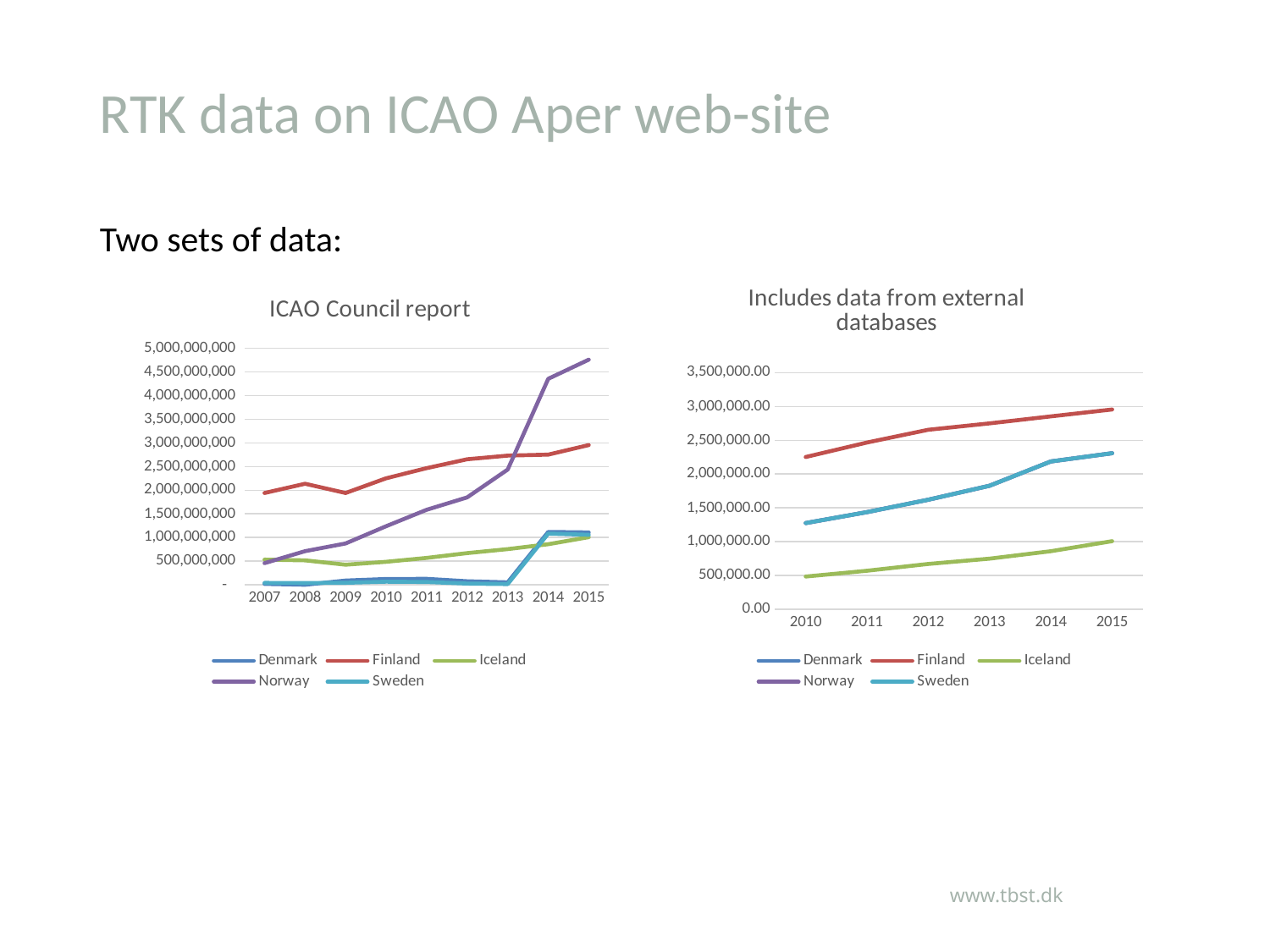
In the 'ICAO Council report' chart, which is larger in 2012: Finland or Norway? Finland In the 'ICAO Council report' chart, how many years are shown on the x axis? 9 In the 'Includes data from external databases' chart, which country has the highest value in 2015? Finland In the 'Includes data from external databases' chart, is the value for Sweden in 2015 greater or less than 2,000,000.00? greater In the 'ICAO Council report' chart, does the Norway line generally rise or fall from 2007 to 2015? rise What type of chart is the 'ICAO Council report' chart? line chart In the 'Includes data from external databases' chart, does the Finland line rise or fall from 2010 to 2015? rise In the 'Includes data from external databases' chart, how many years are shown on the x axis? 6 In the 'ICAO Council report' chart, how many series does the legend list? 5 In the 'ICAO Council report' chart, is the value for Norway in 2015 greater or less than 4,500,000,000? greater In the 'ICAO Council report' chart, which country has the highest value in 2015? Norway